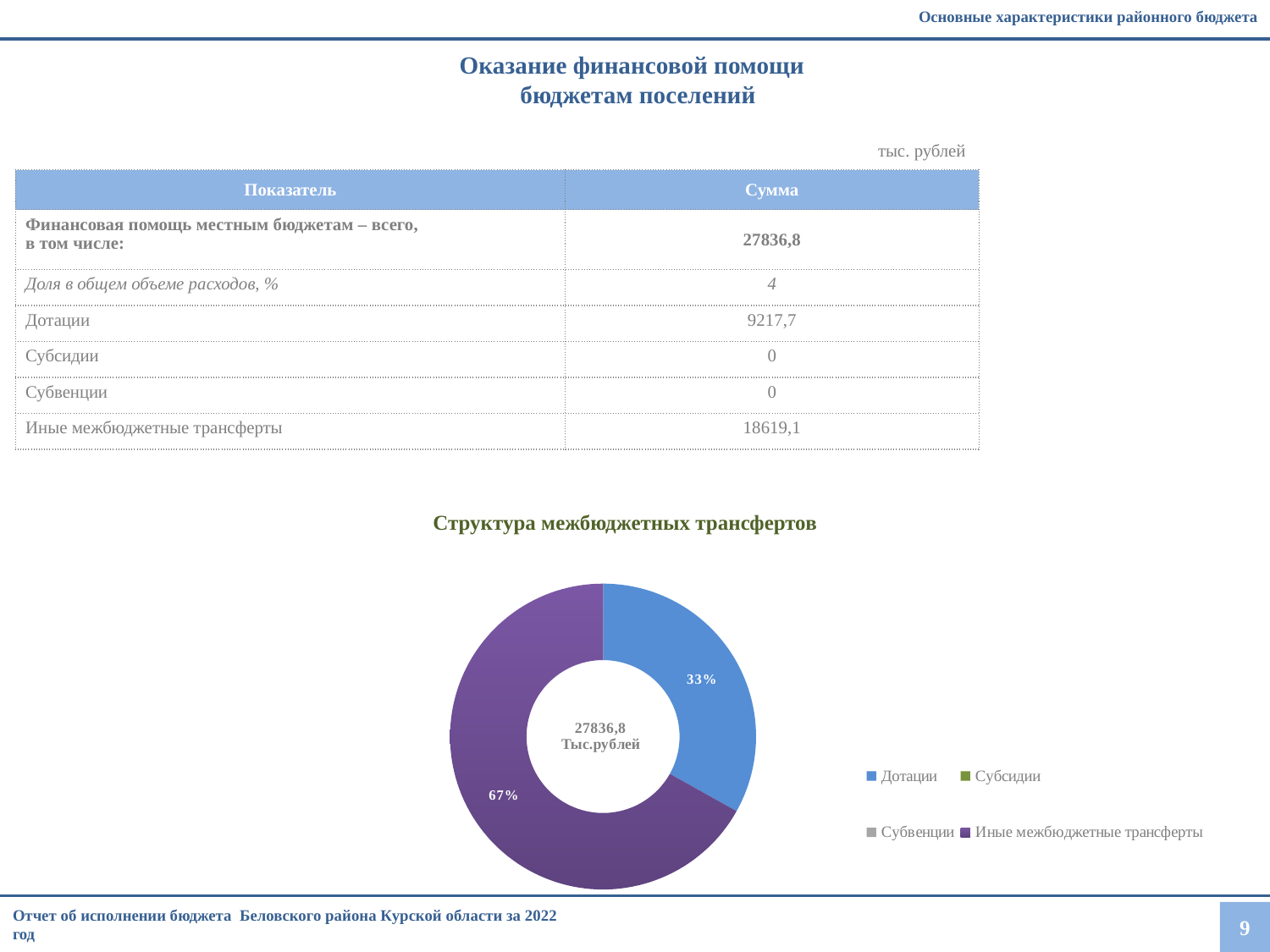
By how many percentage points does the share of Иные межбюджетные трансферты exceed the share of Дотации? 34 Which of the two visible slices is smaller, Дотации or Иные межбюджетные трансферты? Дотации What total value is printed in the centre of the doughnut chart? 27836,8 Тыс.рублей What share of the doughnut chart does Иные межбюджетные трансферты account for? 67% How many entries does the chart legend list? 4 How many slices are visibly plotted in the doughnut chart? 2 Is the slice for Иные межбюджетные трансферты larger or smaller than the slice for Дотации? larger What share of the doughnut chart does Дотации account for? 33% What is the title of the chart? Структура межбюджетных трансфертов What type of chart is shown on the slide? Doughnut (pie) chart Which category has the largest slice in the chart? Иные межбюджетные трансферты